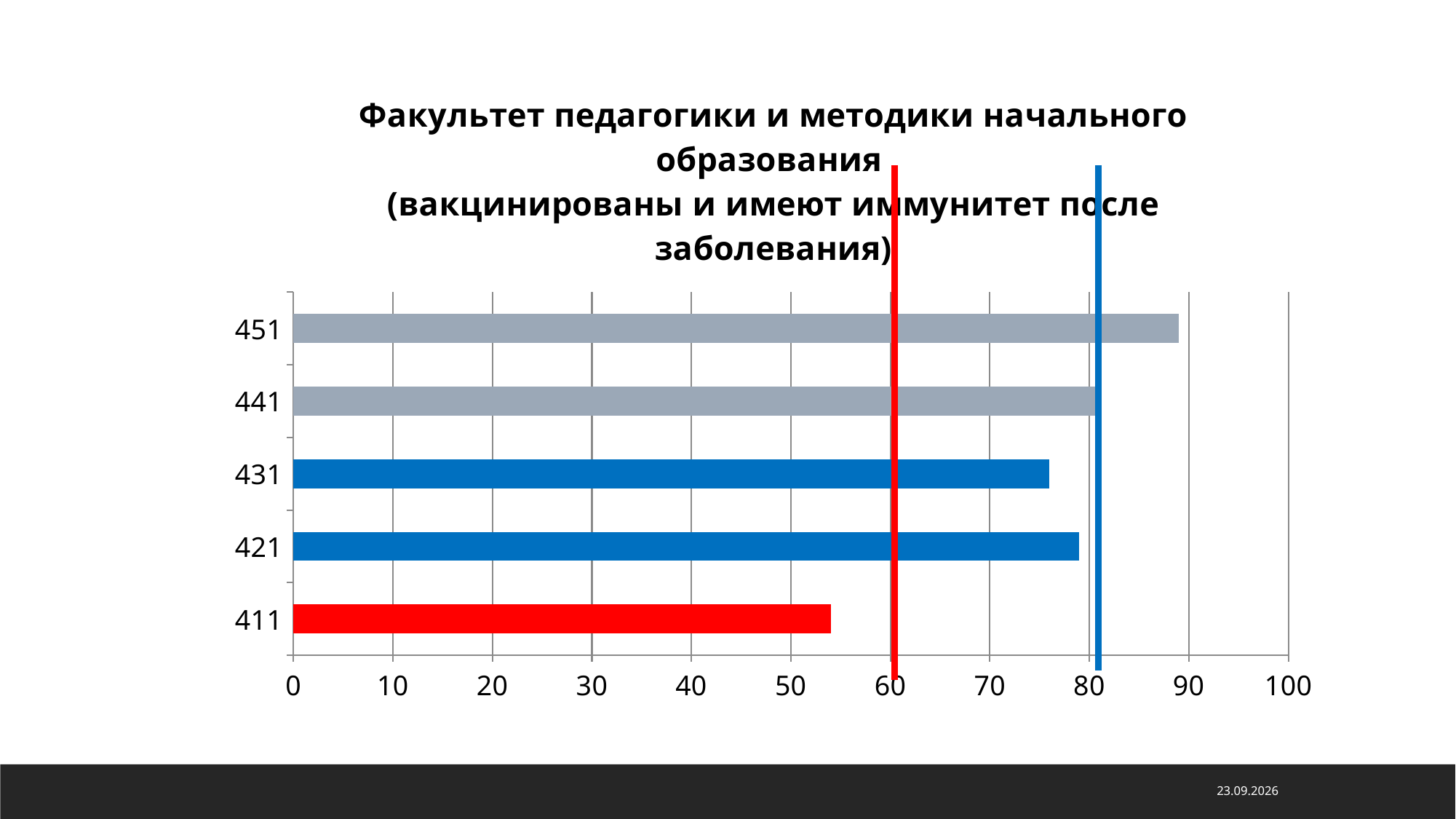
Is the value for 421 greater or less than 70? greater What colour is the bar for category 411? red Which has the larger value, 451 or 411? 451 How many categories are plotted on the chart? 5 Is the value for 431 greater or less than 70? greater Which category has the highest value? 451 Which category has the lowest value? 411 Is the value for 451 greater or less than 80? greater What kind of chart is shown on the slide? bar chart Which has the larger value, 441 or 431? 441